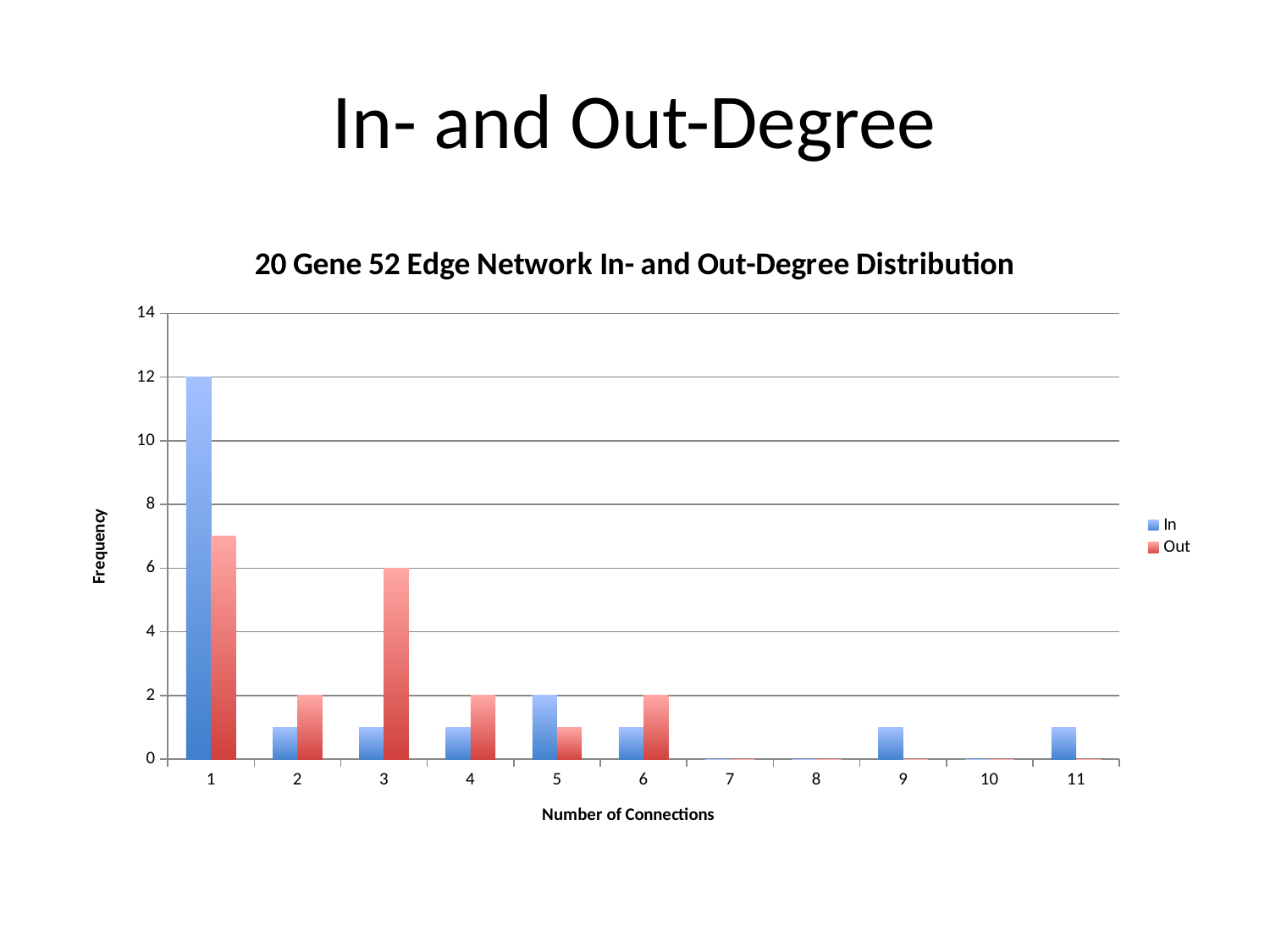
What is the frequency for the Out series at 2 connections? 2 How many categories are shown on the x axis (Number of Connections)? 11 What is the frequency for the In series at 5 connections? 2 What is the difference between the In frequency at 1 connection and the Out frequency at 3 connections? 6 What type of chart is shown on the slide? bar chart At 3 connections, which series has the larger frequency, In or Out? Out What is the frequency for the Out series at 3 connections? 6 How many series does the legend list? 2 Which number of connections has the highest frequency for the Out series? 1 Is the Out frequency at 1 connection greater or less than 6? greater Which number of connections has the highest frequency for the In series? 1 What is the frequency for the In series at 1 connection? 12